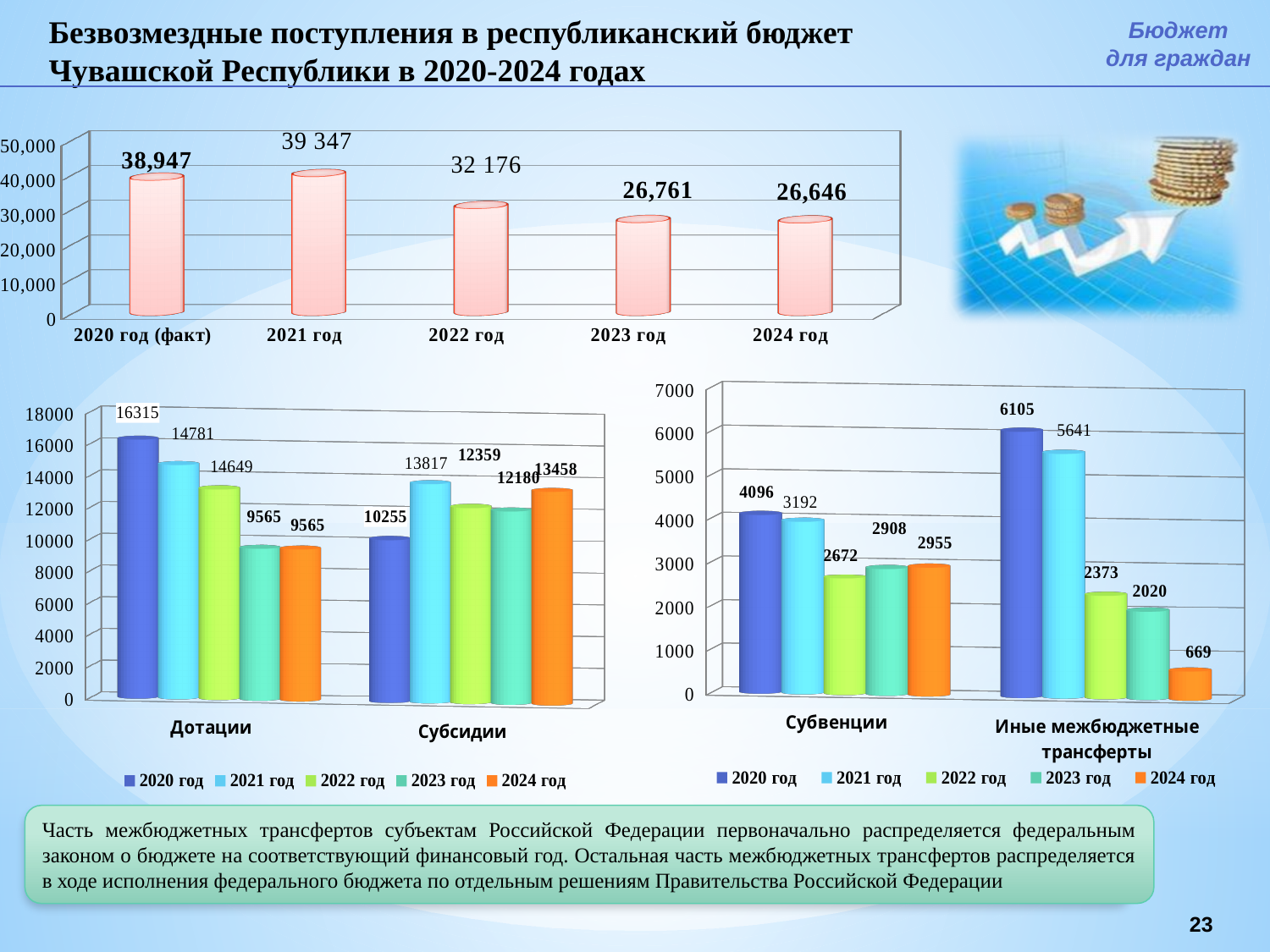
How many years (categories) are shown in the top chart? 5 In the bottom-left chart, what is the value for Субсидии in 2020 год? 10255 What kind of chart is the bottom-left chart? bar chart In the top chart, which year has the highest value? 2021 год In the bottom-left chart, which is larger for Субсидии: 2021 год or 2024 год? 2021 год How many series does the legend of the bottom-left chart list? 5 In the top chart, which year has the lowest value? 2024 год In the bottom-left chart, what is the value for Дотации in 2023 год? 9565 In the top chart, what is the value for 2022 год? 32 176 In the bottom-right chart, what is the difference between Иные межбюджетные трансферты in 2020 год and 2021 год? 464 In the bottom-right chart, what is the value for Иные межбюджетные трансферты in 2024 год? 669 In the top chart, what is the difference between the values for 2020 год (факт) and 2024 год? 12,301